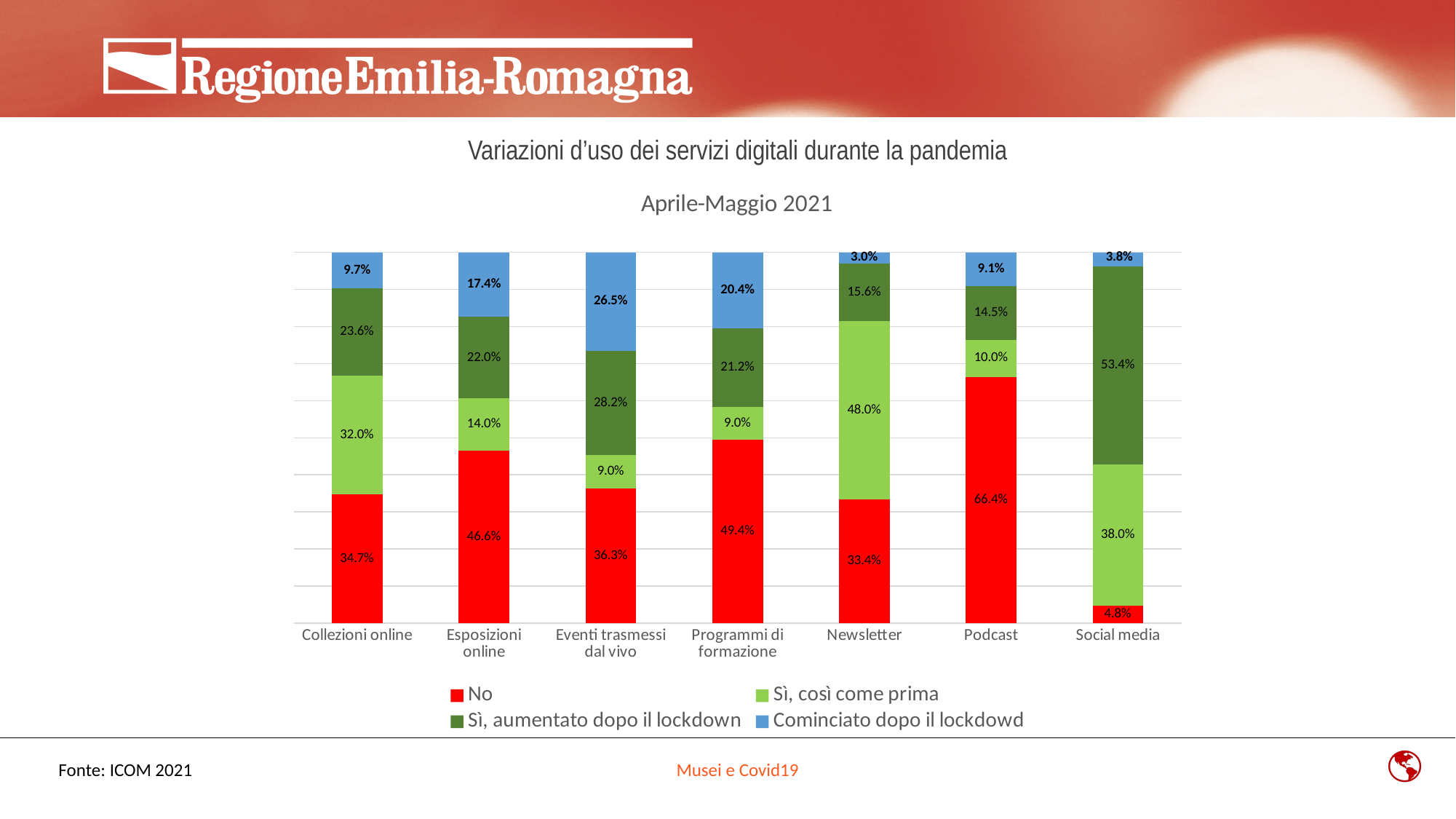
How many digital service categories are shown on the x axis? 7 What kind of chart is shown on the slide? Stacked bar chart What period does the chart subtitle indicate? Aprile-Maggio 2021 What is the value of 'Sì, così come prima' for Newsletter? 48.0% Which category has the lowest 'No' value? Social media How many series does the legend list? 4 Which has a larger 'Cominciato dopo il lockdowd' value, Esposizioni online or Collezioni online? Esposizioni online Which category has the highest 'Cominciato dopo il lockdowd' value? Eventi trasmessi dal vivo What is the value of the 'No' segment for Podcast? 66.4% Which category has the highest 'No' value? Podcast What is the value of 'Cominciato dopo il lockdowd' for Eventi trasmessi dal vivo? 26.5% For Social media, what is the difference between 'Sì, aumentato dopo il lockdown' and 'Sì, così come prima'? 15.4 percentage points